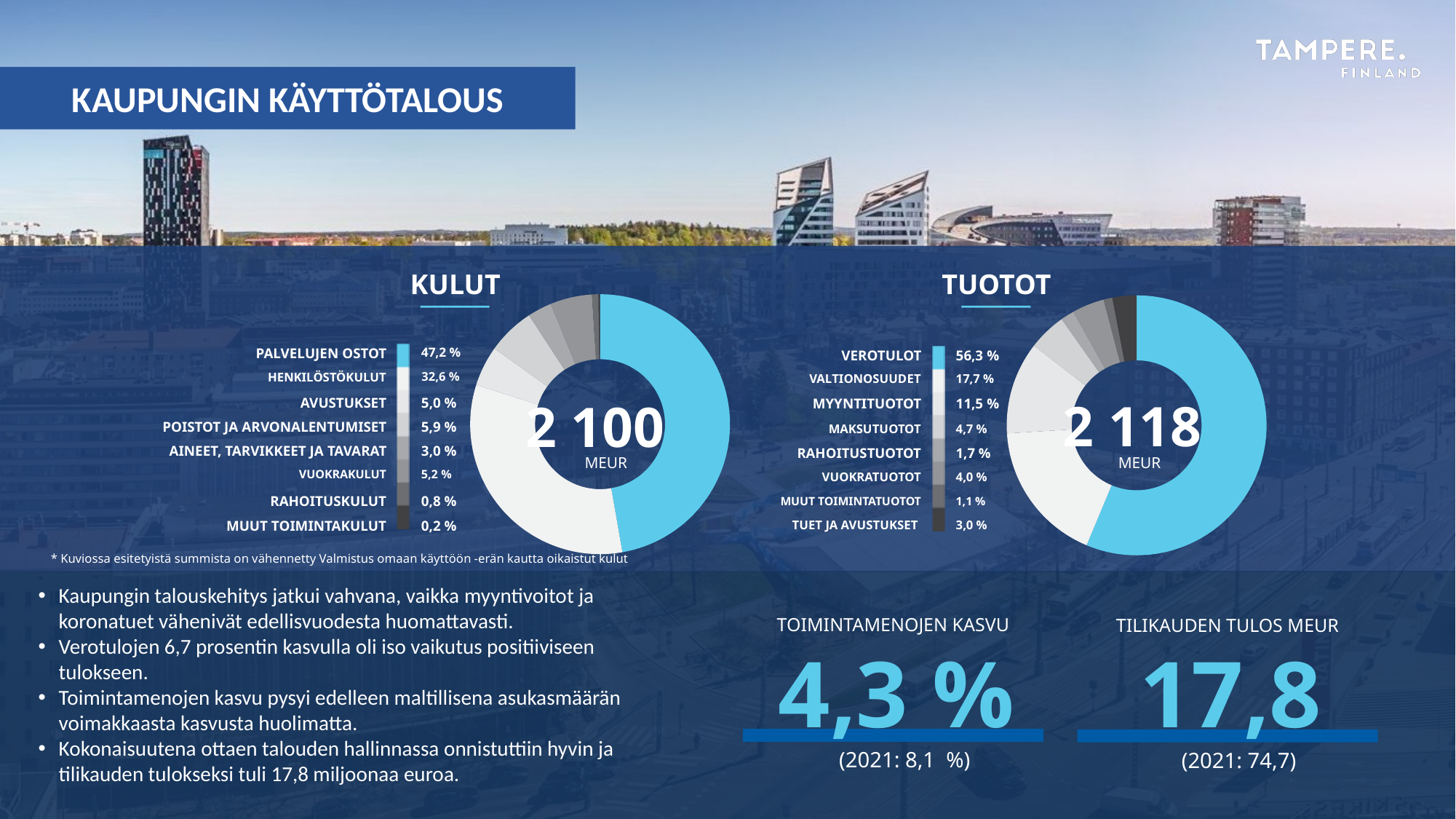
In the TUOTOT chart, what is the difference between the shares of MYYNTITUOTOT and MAKSUTUOTOT? 6,8 % What total value in MEUR is shown in the centre of the TUOTOT chart? 2 118 In the KULUT chart, what is the difference between the shares of PALVELUJEN OSTOT and HENKILÖSTÖKULUT? 14,6 % In the KULUT chart, what share is shown for VUOKRAKULUT? 5,2 % In the KULUT chart, how many categories are listed? 8 What total value in MEUR is shown in the centre of the KULUT chart? 2 100 In the KULUT chart, what share is shown for PALVELUJEN OSTOT? 47,2 % What type of chart is used for KULUT and TUOTOT? Donut (pie) chart In the TUOTOT chart, what share is shown for VALTIONOSUUDET? 17,7 % In the TUOTOT chart, which category has the largest share? VEROTULOT In the TUOTOT chart, which is larger: MAKSUTUOTOT or VUOKRATUOTOT? MAKSUTUOTOT In the KULUT chart, which category has the smallest share? MUUT TOIMINTAKULUT